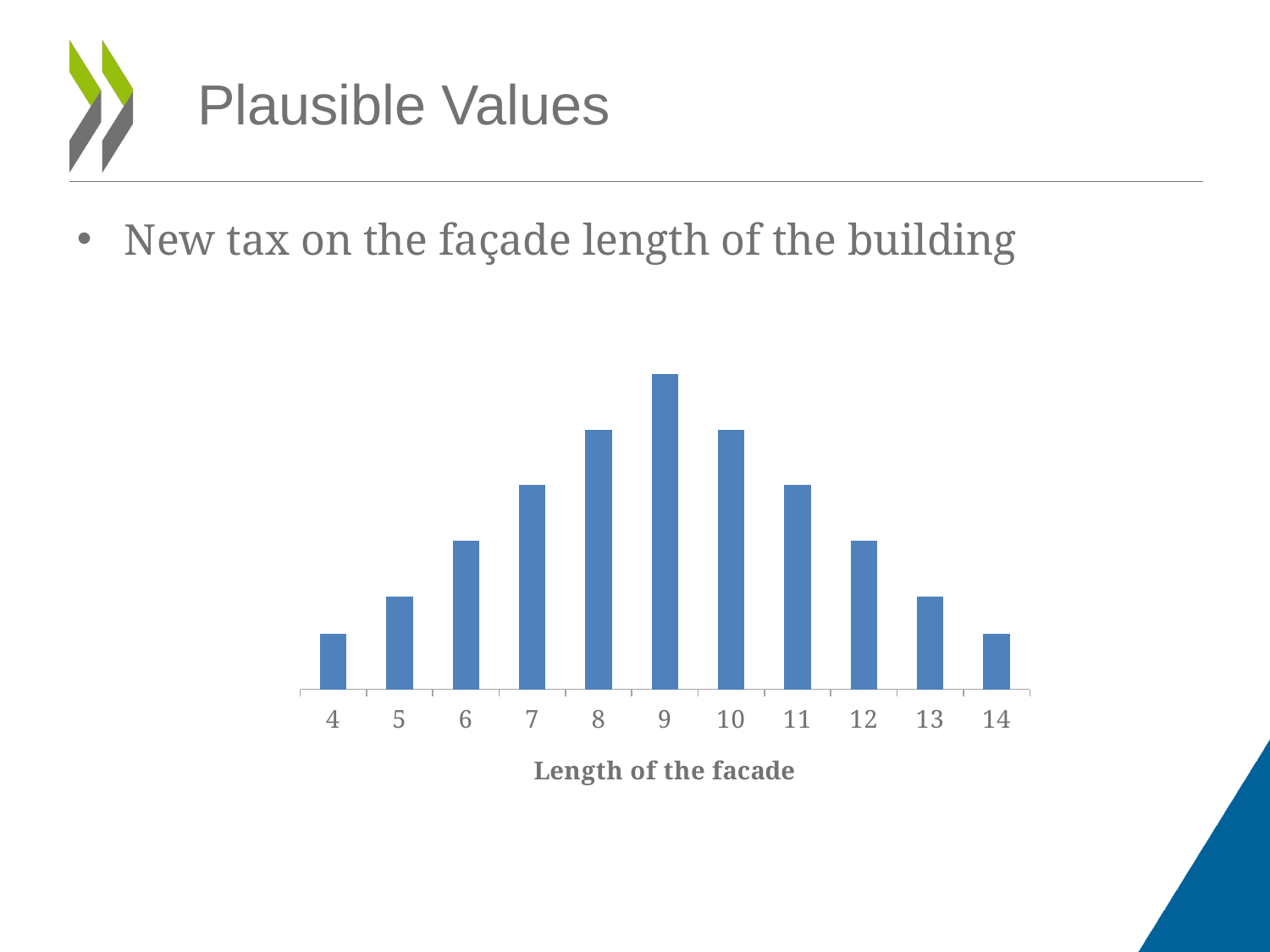
What kind of chart is shown on the slide? Bar chart Which facade length has the tallest bar? 9 What is the title of the x axis of the chart? Length of the facade Which bar is taller, the one for facade length 12 or the one for facade length 13? 12 Which bar is taller, the one for facade length 9 or the one for facade length 4? 9 Which bar is taller, the one for facade length 6 or the one for facade length 14? 6 How do the bar heights change as the facade length increases from 9 to 14? They fall How do the bar heights change as the facade length increases from 4 to 9? They rise How many facade length categories are shown on the x axis? 11 What colour are the bars in the chart? Blue